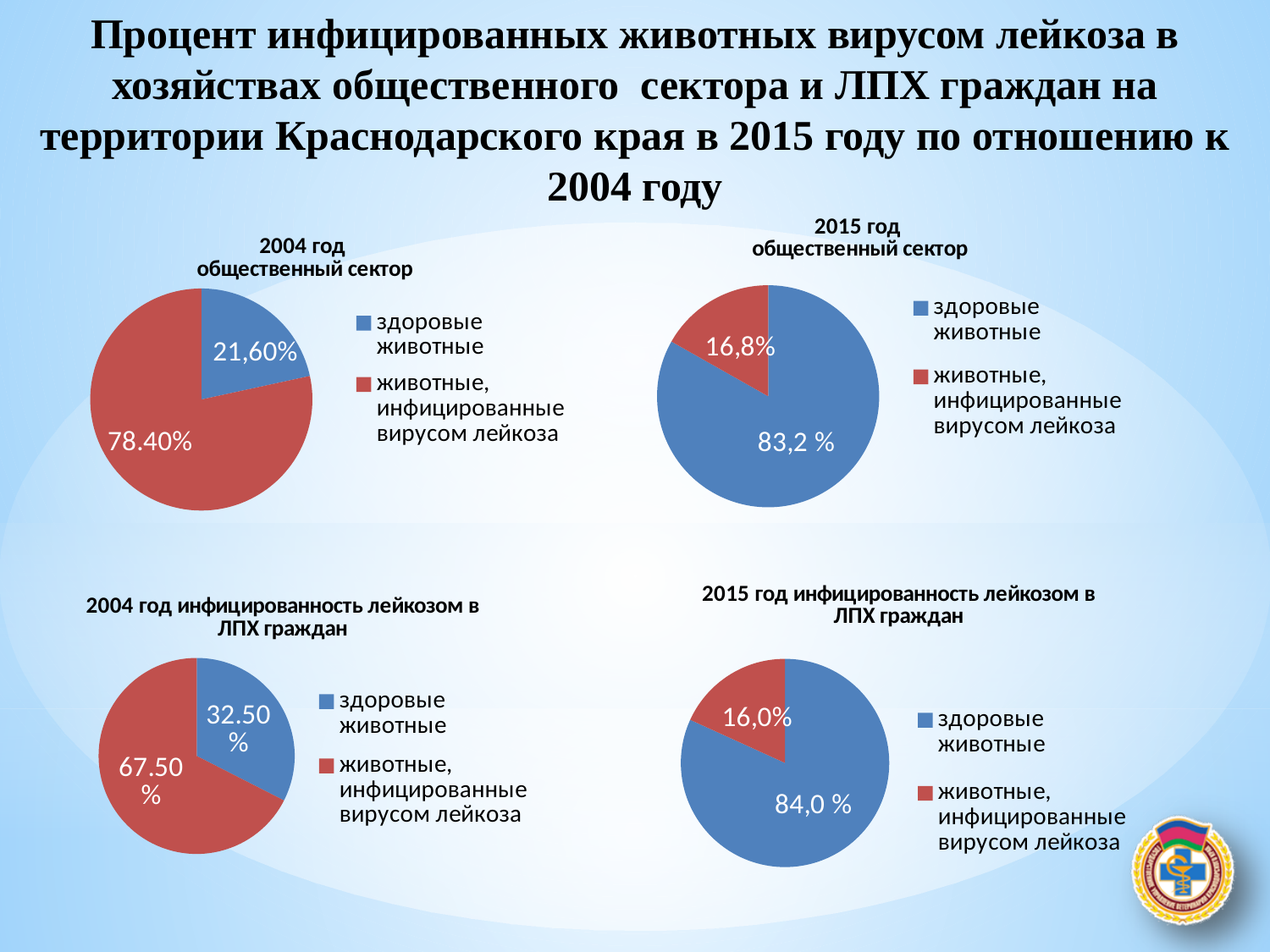
On the chart titled "2015 год инфицированность лейкозом в ЛПХ граждан", what colour is the slice for здоровые животные? blue On the chart titled "2015 год общественный сектор", what share is labelled for животные, инфицированные вирусом лейкоза? 16,8% On the chart titled "2004 год инфицированность лейкозом в ЛПХ граждан", which slice is larger: здоровые животные or животные, инфицированные вирусом лейкоза? животные, инфицированные вирусом лейкоза On the chart titled "2015 год общественный сектор", what share is labelled for здоровые животные? 83,2 % On the chart titled "2004 год общественный сектор", what share is labelled for здоровые животные? 21,60% How many slices does the chart titled "2004 год инфицированность лейкозом в ЛПХ граждан" have? 2 What kind of chart is the chart titled "2015 год общественный сектор"? pie chart On the chart titled "2004 год общественный сектор", which category has the smallest slice? здоровые животные On the chart titled "2015 год инфицированность лейкозом в ЛПХ граждан", what share is labelled for животные, инфицированные вирусом лейкоза? 16,0% On the chart titled "2004 год общественный сектор", what share is labelled for животные, инфицированные вирусом лейкоза? 78.40% On the chart titled "2015 год инфицированность лейкозом в ЛПХ граждан", which category has the largest slice? здоровые животные On the chart titled "2004 год инфицированность лейкозом в ЛПХ граждан", what share is labelled for здоровые животные? 32.50%